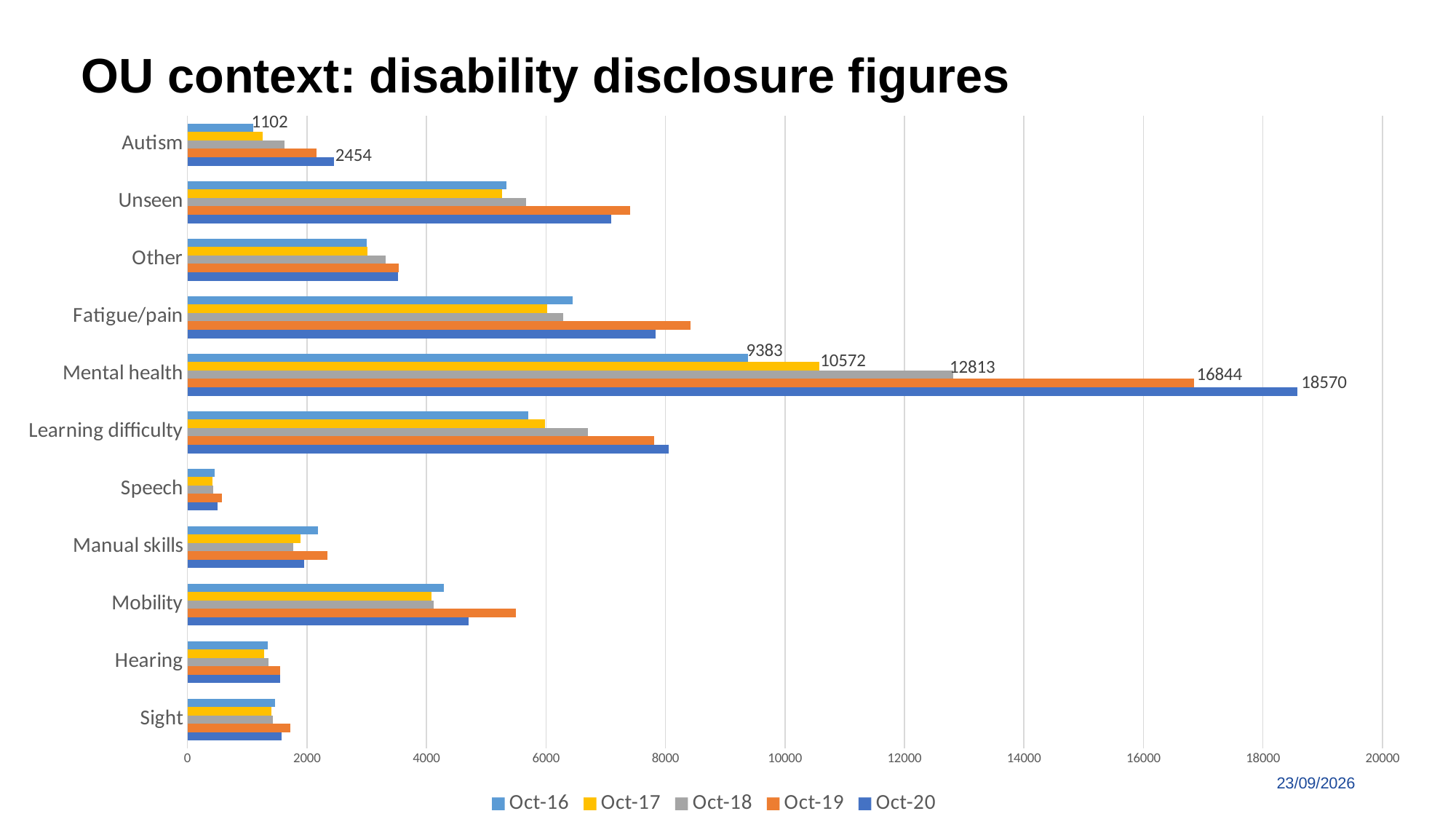
What is the Oct-20 value for Mental health? 18570 What is the Oct-20 value for Autism? 2454 How many series does the legend list? 5 What is the Oct-18 value for Mental health? 12813 Which category has the lowest Oct-19 value? Speech What is the Oct-16 value for Autism? 1102 What is the difference between the Oct-20 and Oct-16 values for Mental health? 9187 Is the Oct-19 value for Fatigue/pain greater or less than 8000? greater What is the difference between the Oct-19 and Oct-17 values for Mental health? 6272 Which is larger for Mobility: the Oct-19 value or the Oct-20 value? Oct-19 Which category has the highest Oct-20 value? Mental health What kind of chart is shown on the slide? Bar chart